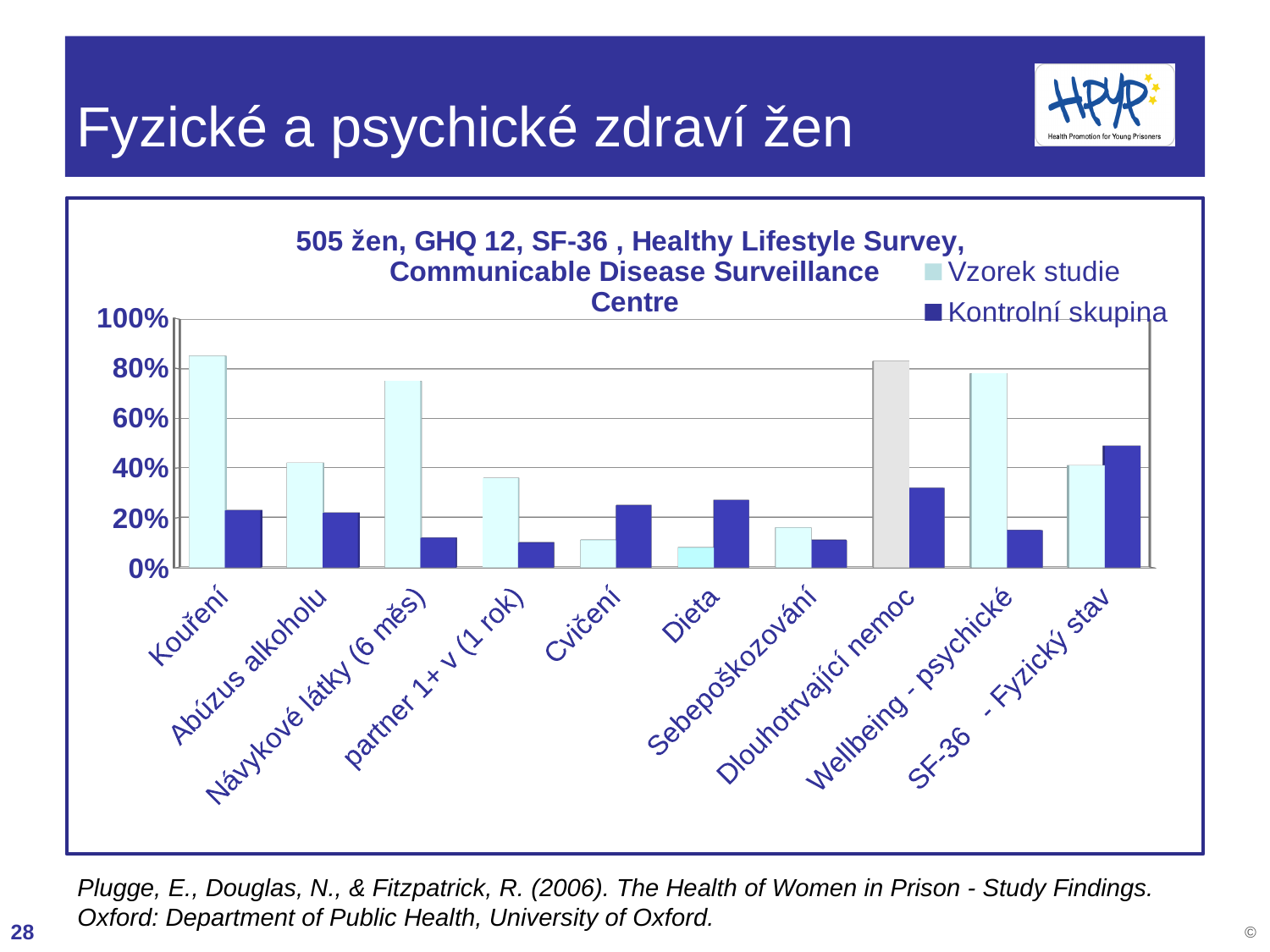
For Dieta, which series has the larger value, Vzorek studie or Kontrolní skupina? Kontrolní skupina Which legend entry is shown with the dark blue colour? Kontrolní skupina Is the Vzorek studie value for Kouření greater or less than 80%? greater For Cvičení, which series has the larger value, Vzorek studie or Kontrolní skupina? Kontrolní skupina Which category has the highest value for Kontrolní skupina? SF-36 - Fyzický stav Is the Kontrolní skupina value for Wellbeing - psychické greater or less than 20%? less For Kouření, which series has the larger value, Vzorek studie or Kontrolní skupina? Vzorek studie What kind of chart is shown on the slide? bar chart Is the Kontrolní skupina value for SF-36 - Fyzický stav greater or less than 40%? greater How many series does the legend list? 2 How many categories are shown on the x axis? 10